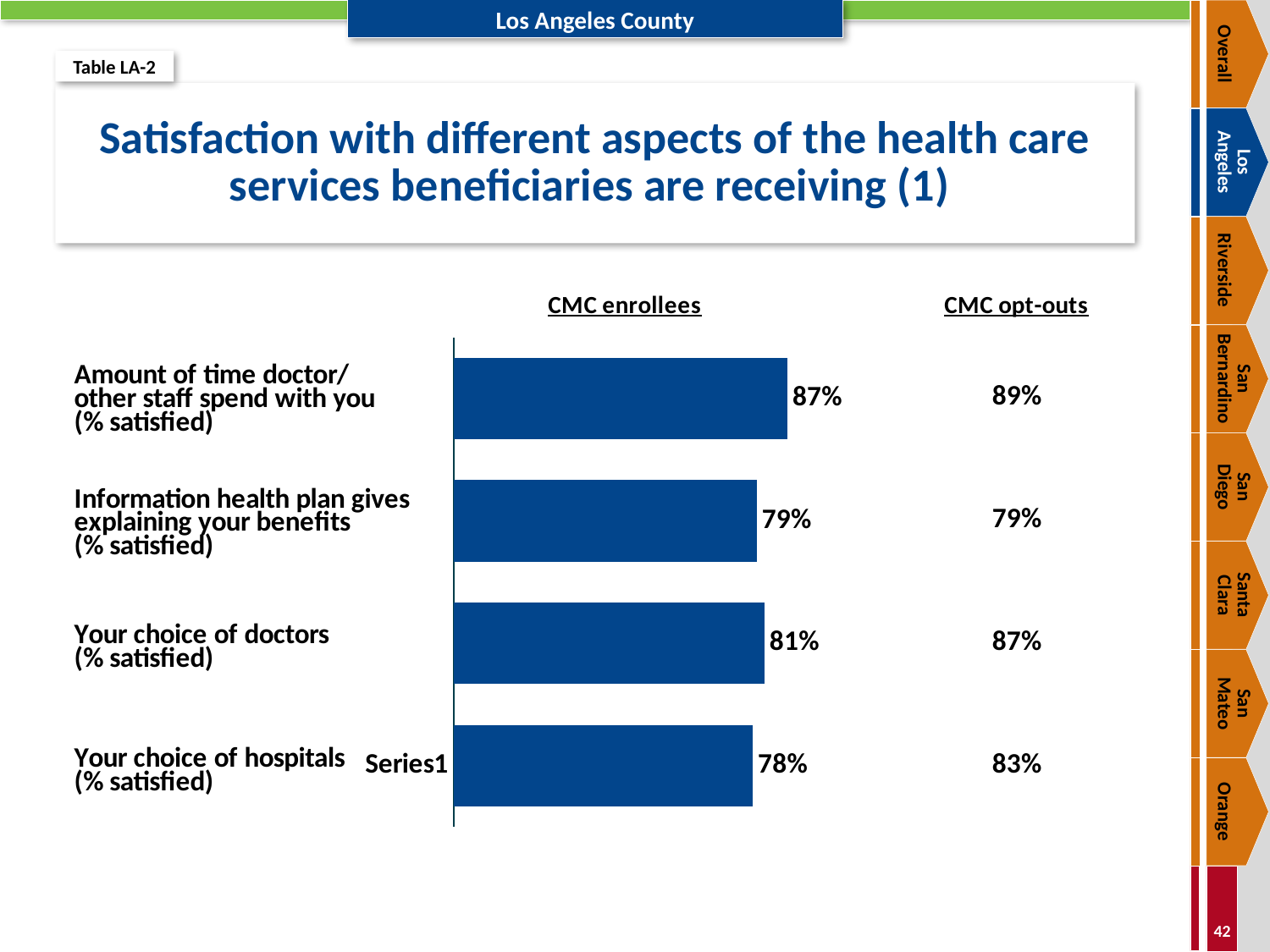
What is the CMC enrollees value for 'Your choice of doctors (% satisfied)'? 81% Which aspect has the highest CMC enrollees satisfaction bar? Amount of time doctor/other staff spend with you What is the CMC enrollees value for 'Information health plan gives explaining your benefits (% satisfied)'? 79% What is the CMC enrollees value for 'Amount of time doctor/other staff spend with you (% satisfied)'? 87% What is the difference between the CMC enrollees values for 'Your choice of doctors' and 'Your choice of hospitals'? 3% What is the CMC enrollees value for 'Your choice of hospitals (% satisfied)'? 78% What is the difference between the CMC enrollees values for 'Amount of time doctor/other staff spend with you' and 'Your choice of hospitals'? 9% What is the title of the chart on the slide? Satisfaction with different aspects of the health care services beneficiaries are receiving (1) Which has a larger CMC enrollees value: 'Your choice of doctors' or 'Information health plan gives explaining your benefits'? Your choice of doctors Which aspect has the lowest CMC enrollees satisfaction bar? Your choice of hospitals How many bars are plotted in the chart? 4 What kind of chart is shown on the slide? Bar chart